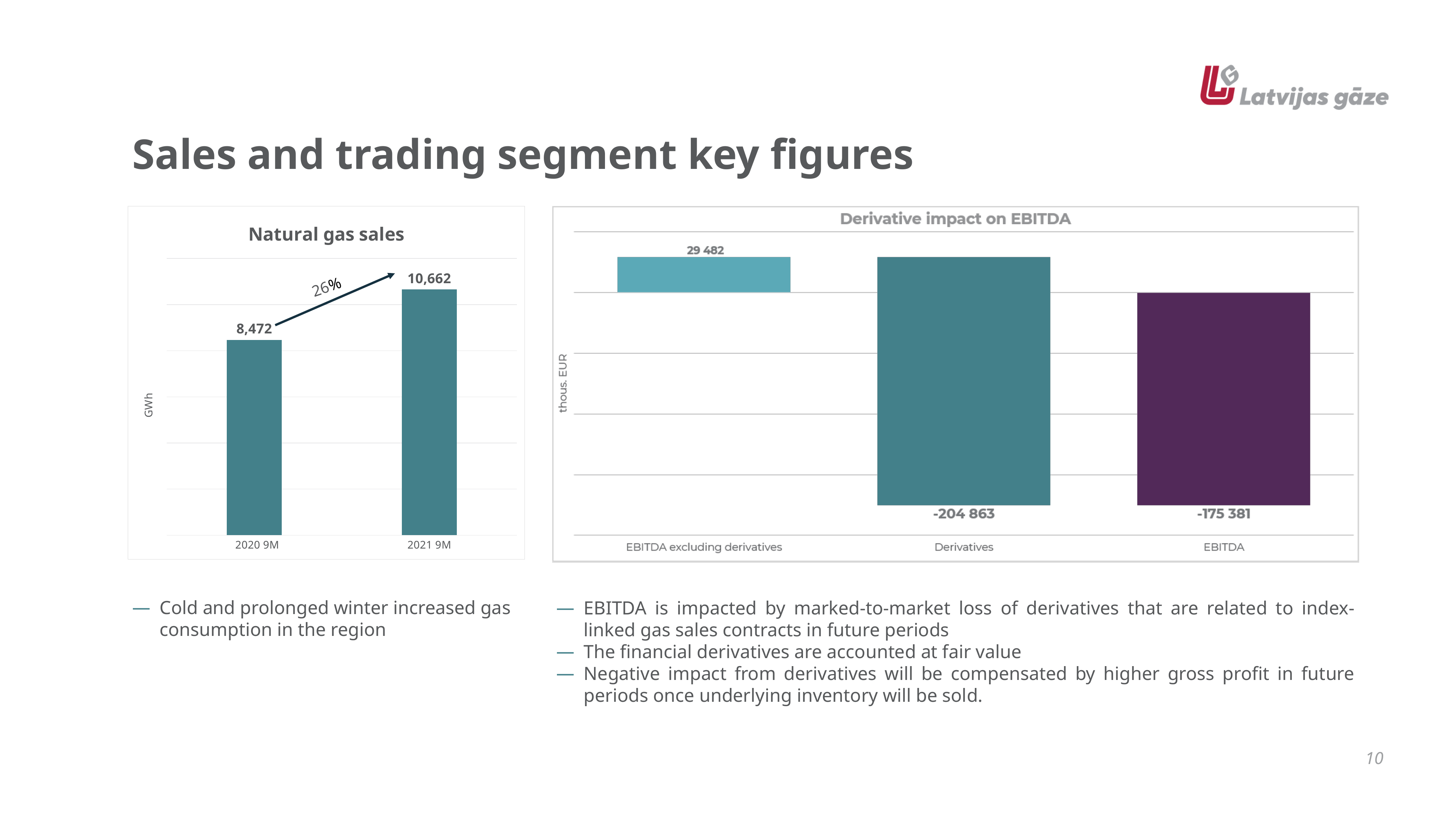
In the Derivative impact on EBITDA chart, what is the value for Derivatives? -204 863 What kind of chart is the Derivative impact on EBITDA chart? bar chart In the Derivative impact on EBITDA chart, which category has the lowest value? Derivatives In the Derivative impact on EBITDA chart, what is the value for EBITDA excluding derivatives? 29 482 In the Derivative impact on EBITDA chart, what is the value for EBITDA? -175 381 In the Natural gas sales chart, by how much did sales increase from 2020 9M to 2021 9M? 2,190 In the Natural gas sales chart, what unit is shown on the vertical axis? GWh In the Derivative impact on EBITDA chart, how many categories are shown? 3 In the Natural gas sales chart, what percentage change is shown by the arrow between 2020 9M and 2021 9M? 26% In the Natural gas sales chart, what is the value for 2020 9M? 8,472 In the Natural gas sales chart, what is the value for 2021 9M? 10,662 In the Natural gas sales chart, do sales rise or fall from 2020 9M to 2021 9M? rise